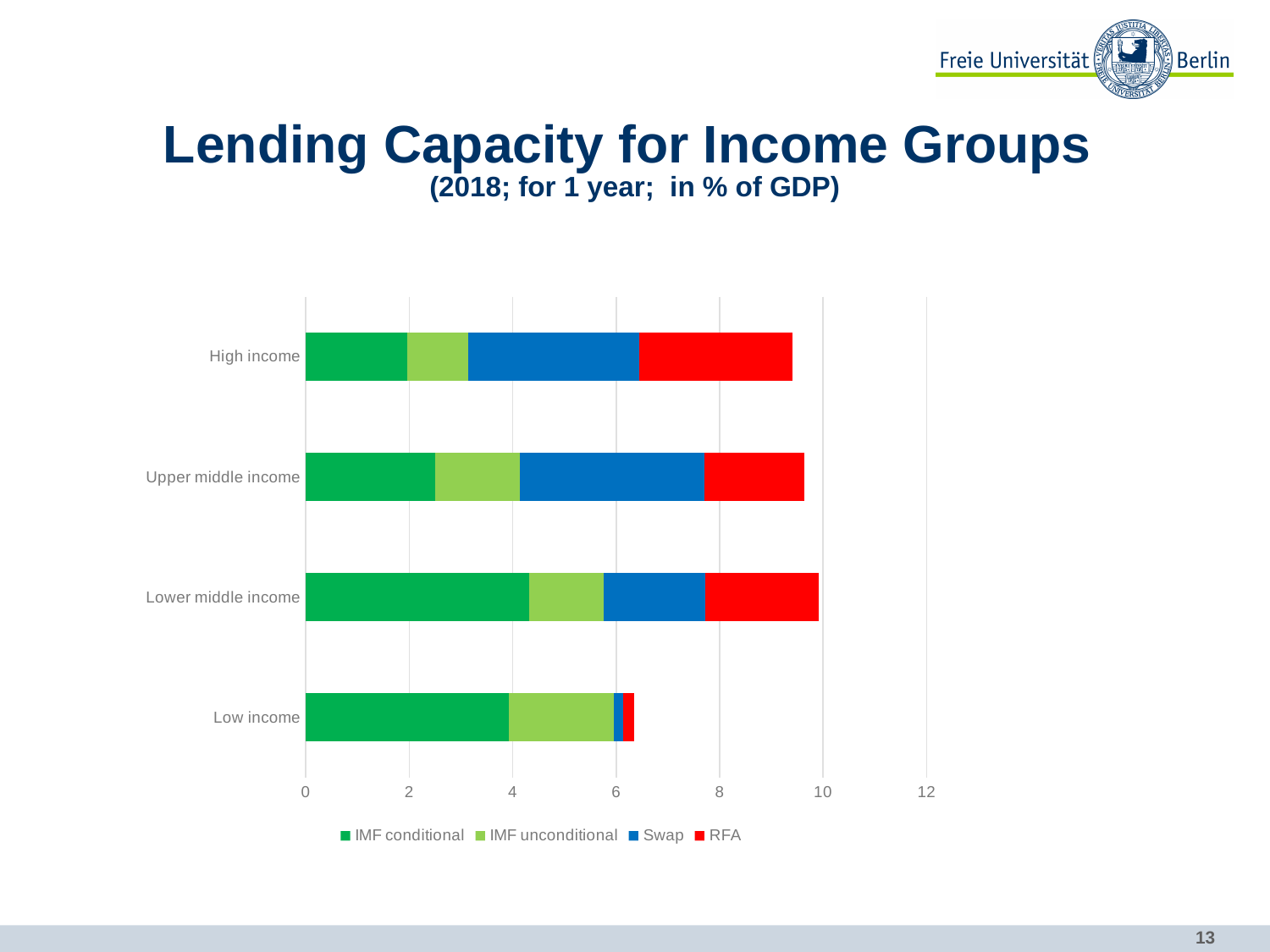
Which series is shown in red in the legend? RFA Which income group has the shortest total bar? Low income What kind of chart is shown on the slide? Stacked bar chart Is the total bar for High income greater or less than 8? greater Is the total bar for Low income greater or less than 8? less Which is larger, the IMF conditional value for Low income or for High income? Low income Is the total bar for Lower middle income greater or less than 8? greater Which is larger, the Swap value for High income or for Low income? High income How many income groups are shown on the chart? 4 How many series does the legend list? 4 What is the title of the chart on the slide? Lending Capacity for Income Groups